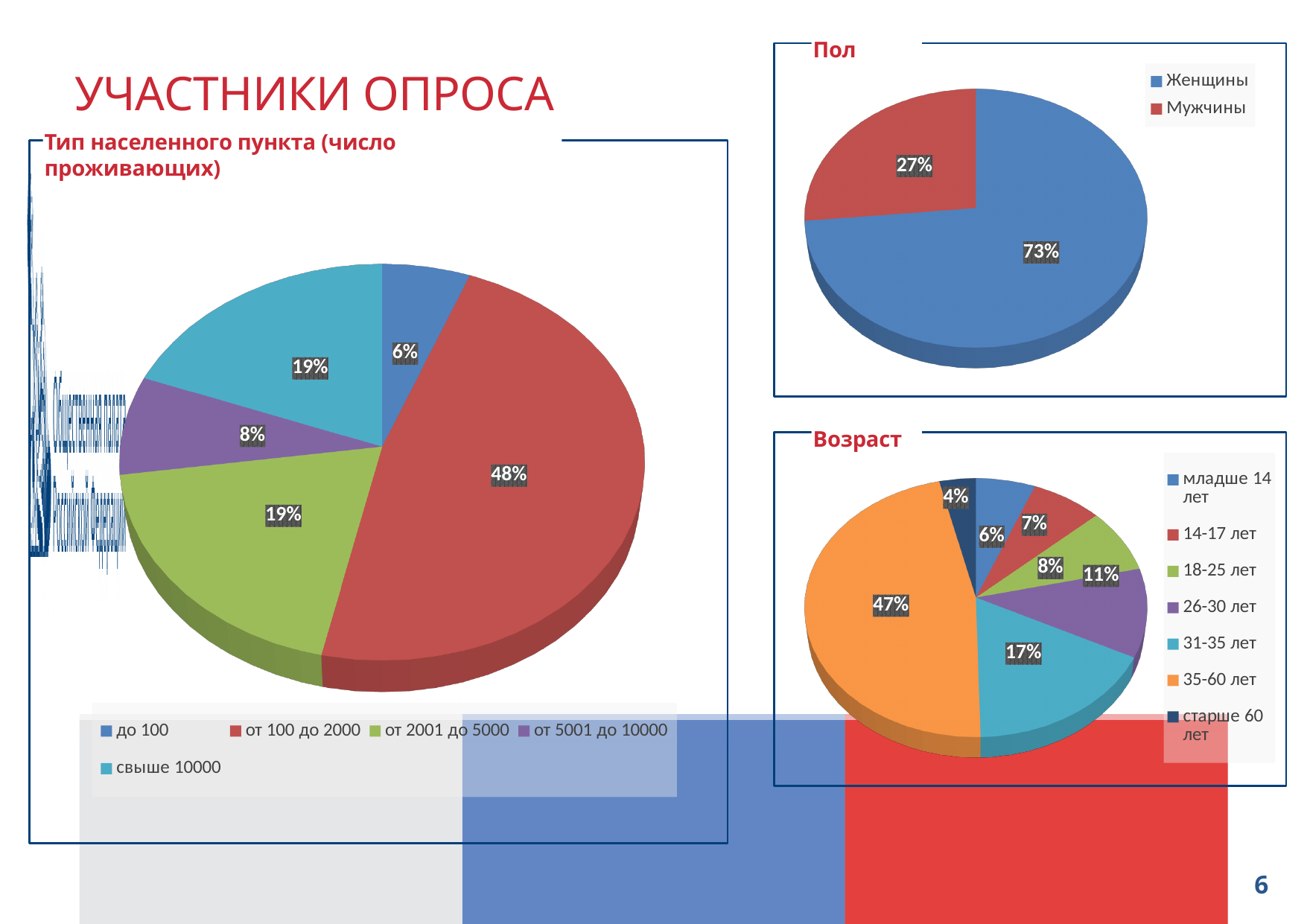
In the chart titled "Возраст", which age group has the smallest share? старше 60 лет In the chart titled "Тип населенного пункта (число проживающих)", which category has the smallest share? до 100 In the chart titled "Возраст", what percentage is shown for "31-35 лет"? 17% In the chart titled "Пол", what percentage is shown for Женщины? 73% In the chart titled "Возраст", how many age groups does the legend list? 7 In the chart titled "Возраст", which age group has the largest share? 35-60 лет In the chart titled "Тип населенного пункта (число проживающих)", what percentage is shown for "от 5001 до 10000"? 8% In the chart titled "Тип населенного пункта (число проживающих)", what percentage is shown for "от 100 до 2000"? 48% In the chart titled "Тип населенного пункта (число проживающих)", how many categories does the legend list? 5 What type of chart is used for "Возраст"? Pie chart In the chart titled "Пол", what percentage is shown for Мужчины? 27% In the chart titled "Пол", what is the difference between the Женщины and Мужчины shares? 46%